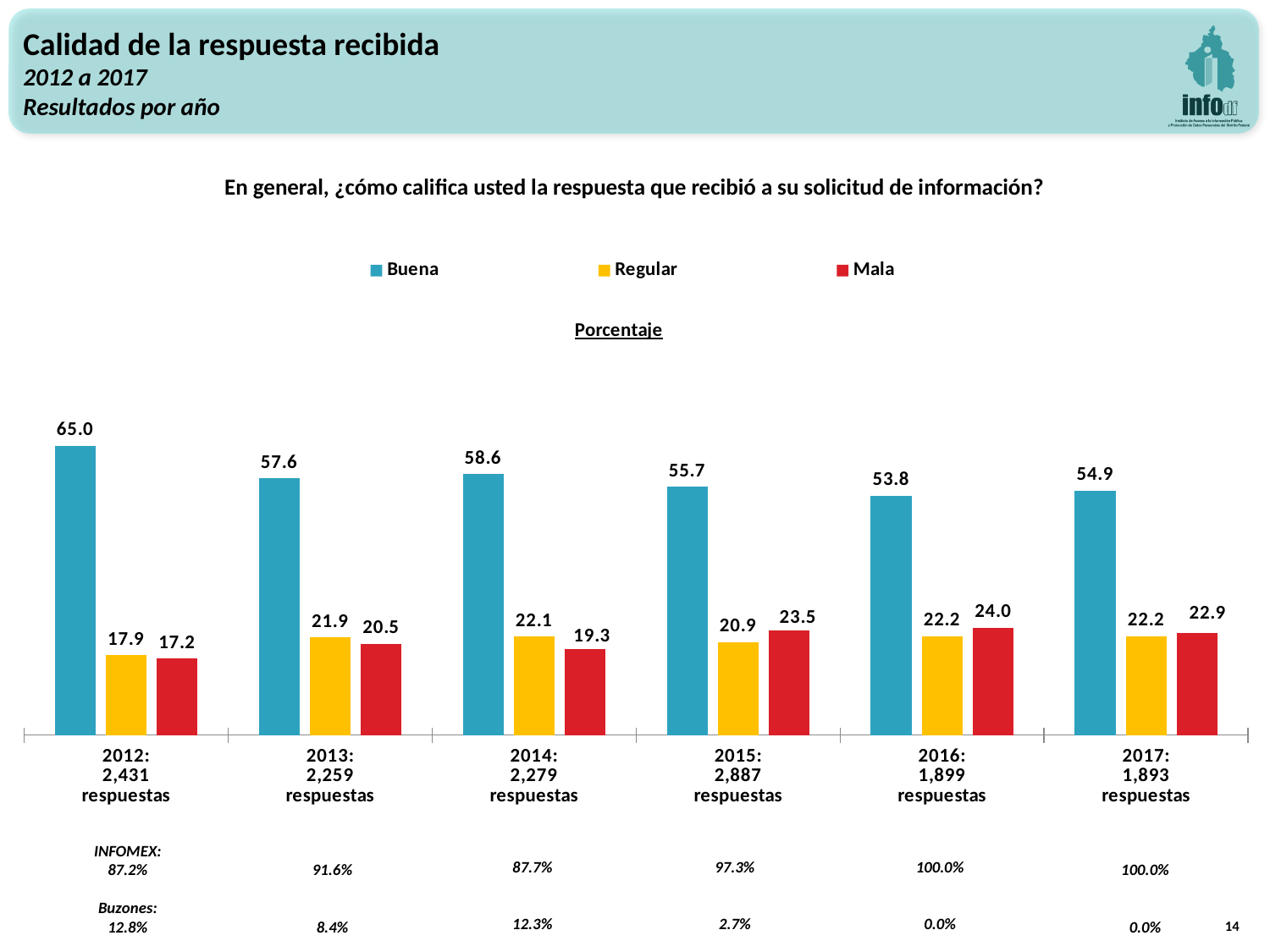
What kind of chart is shown? Bar chart What is the difference between the Buena values for 2012 and 2013? 7.4 What is the value for Regular in 2014? 22.1 In which year is the Buena value lowest? 2016 In which year is the Buena value highest? 2012 Does the Buena value rise or fall from 2012 to 2013? Fall Which is larger in 2015, Regular or Mala? Mala What is the value for Mala in 2016? 24.0 How many years are shown on the x axis? 6 What colour represents the Regular series? Yellow What is the value for Buena in 2012? 65.0 How many series does the legend list? 3